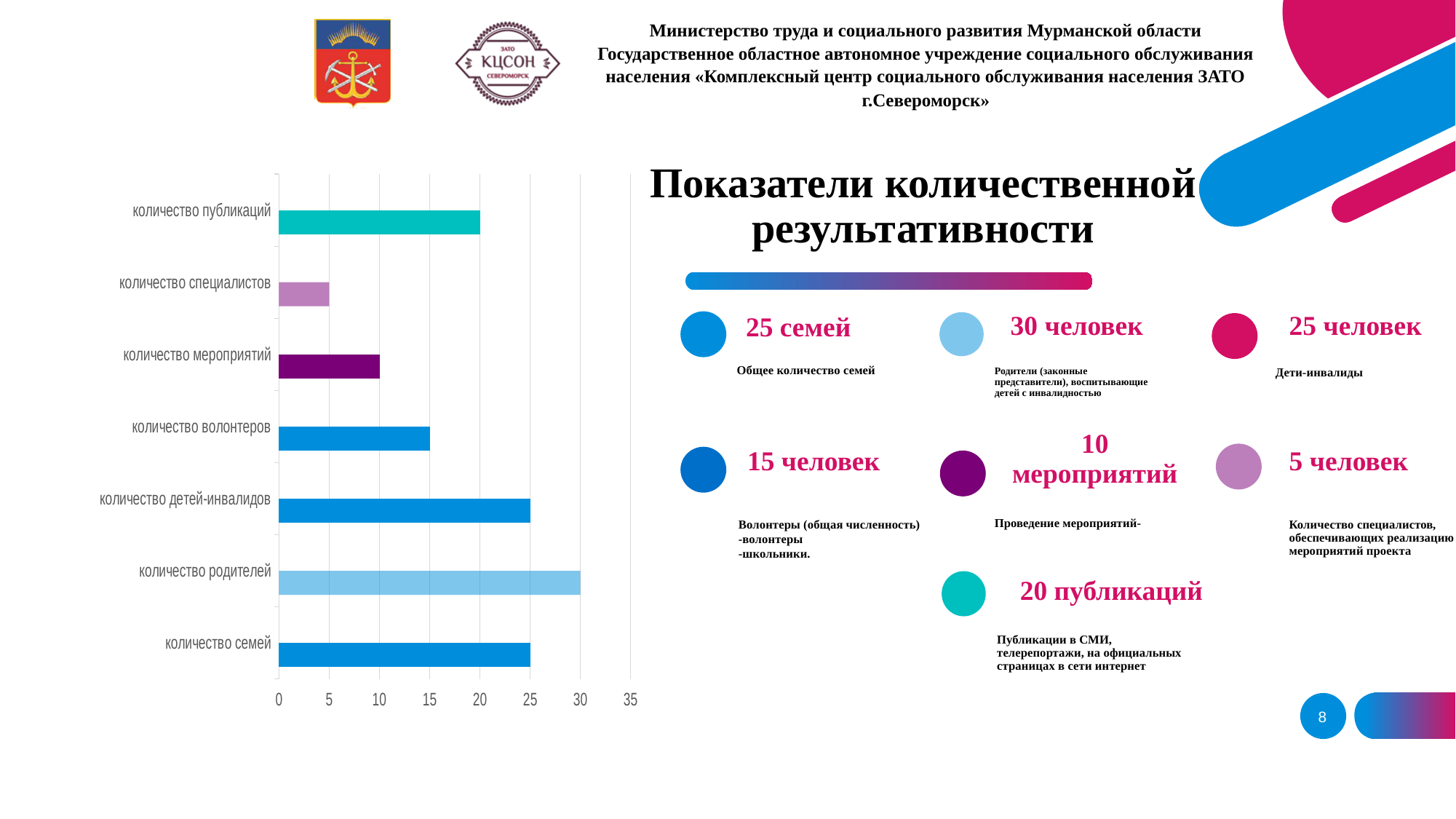
Which category has the highest value in the bar chart? количество родителей What is the value for "количество волонтеров" in the bar chart? 15 What is the difference between the values for "количество родителей" and "количество мероприятий"? 20 What kind of chart is shown on the left of the slide? bar chart How many categories does the bar chart show? 7 What is the value for "количество специалистов" in the bar chart? 5 What is the highest tick value shown on the horizontal axis of the bar chart? 35 Which is larger in the bar chart: "количество публикаций" or "количество волонтеров"? количество публикаций What is the value for "количество публикаций" in the bar chart? 20 What is the value for "количество родителей" in the bar chart? 30 Which category has the lowest value in the bar chart? количество специалистов Is the value for "количество детей-инвалидов" greater or less than 20? greater